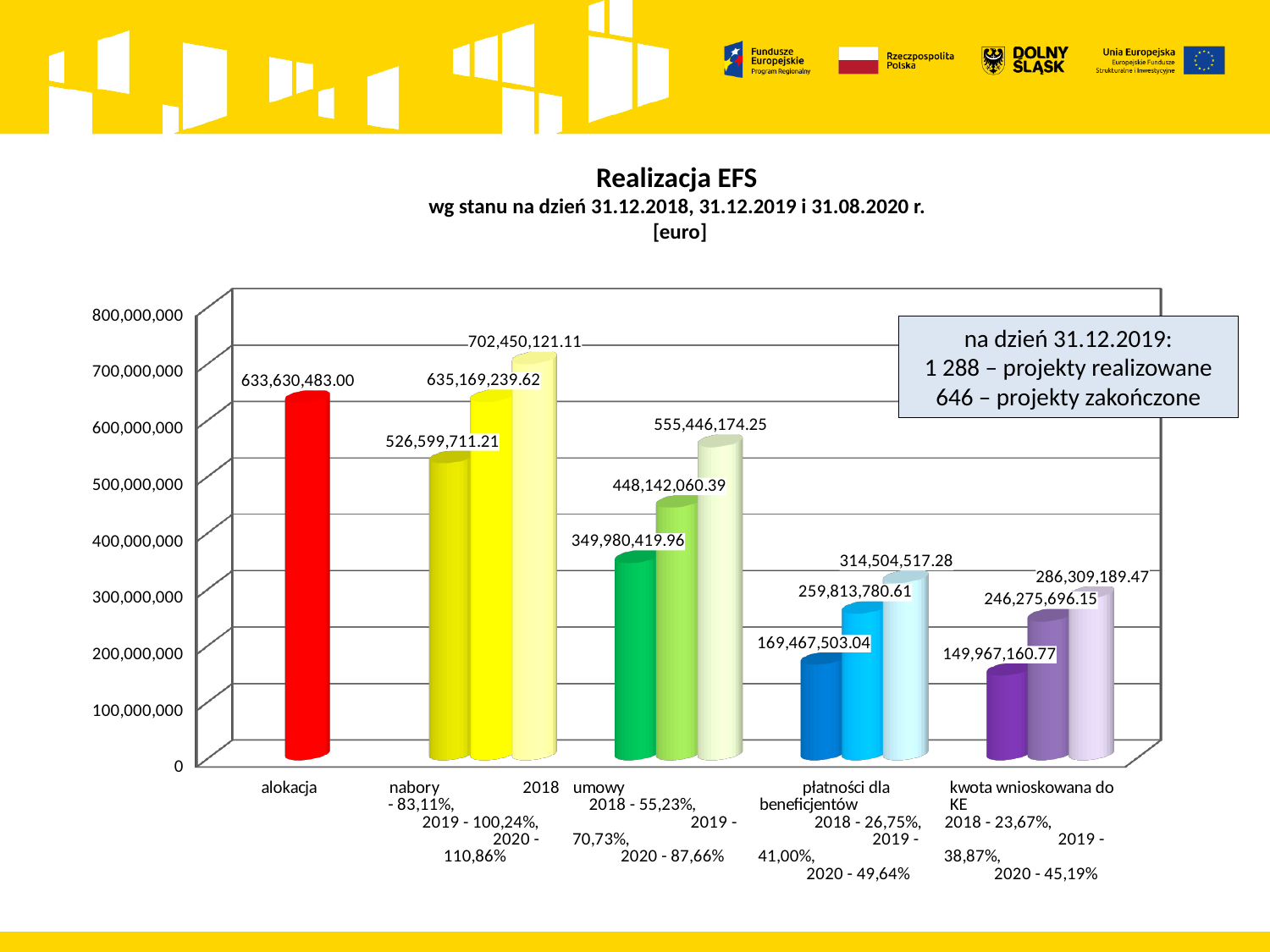
How many categories are shown on the x axis? 5 Which is larger: the alokacja bar or the middle nabory bar (635,169,239.62)? the middle nabory bar (635,169,239.62) What type of chart is shown on the slide? bar chart What unit is stated in the chart title? euro What is the difference between the highest and lowest nabory bars (702,450,121.11 and 526,599,711.21)? 175,850,409.90 What is the highest value shown for the nabory category? 702,450,121.11 Which bar has the lowest value on the whole chart? 149,967,160.77 (kwota wnioskowana do KE) What is the lowest value shown for the umowy category? 349,980,419.96 What is the value of the shortest bar in the kwota wnioskowana do KE category? 149,967,160.77 What is the value of the alokacja bar? 633,630,483.00 What is the value of the tallest bar in the płatności dla beneficjentów category? 314,504,517.28 Which bar has the highest value on the whole chart? 702,450,121.11 (nabory)